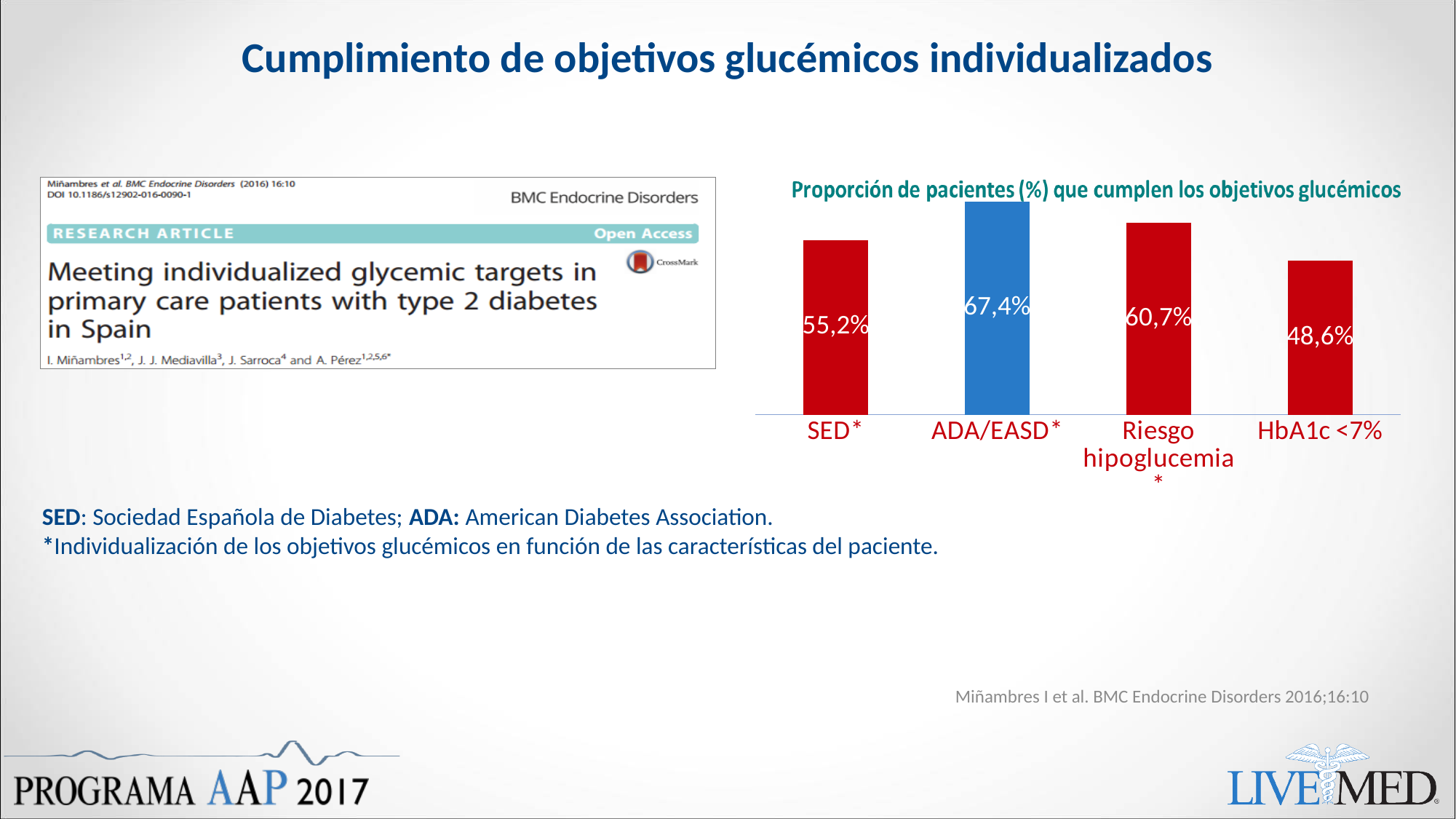
How many categories are shown in the chart? 4 What is the value for Riesgo hipoglucemia* in the chart? 60,7% Which is larger, the value for SED* or the value for Riesgo hipoglucemia*? Riesgo hipoglucemia* Which category has the highest value in the chart? ADA/EASD* What is the title of the chart? Proporción de pacientes (%) que cumplen los objetivos glucémicos What is the difference between the values for ADA/EASD* and SED*? 12,2% Which category has the lowest value in the chart? HbA1c <7% What is the difference between the values for Riesgo hipoglucemia* and HbA1c <7%? 12,1% What is the value for ADA/EASD* in the chart? 67,4% What is the value for HbA1c <7% in the chart? 48,6% What kind of chart is shown on the slide? Bar chart What is the value for SED* in the chart? 55,2%